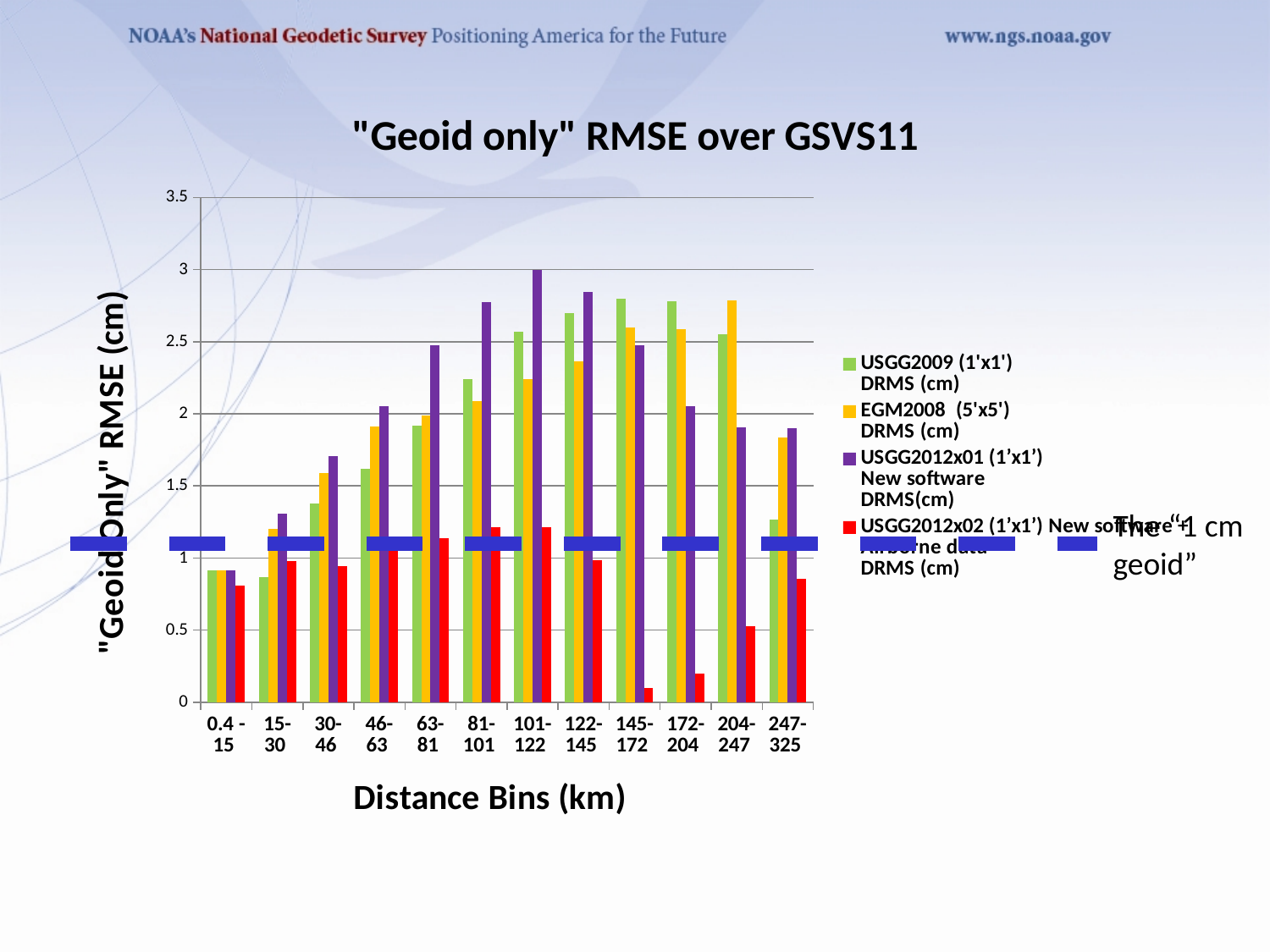
What is the title of the chart? "Geoid only" RMSE over GSVS11 How many distance bins are shown on the x axis of the chart? 12 Is the USGG2012x01 (1'x1') New software DRMS value for the 101-122 km bin greater or less than 2.5? greater In which distance bin does the USGG2012x01 (1'x1') New software DRMS series reach its highest value? 101-122 What is the x-axis title of the chart? Distance Bins (km) Is the USGG2012x02 (1'x1') New software + Airborne data DRMS value for the 172-204 km bin greater or less than 0.5? less Is the USGG2012x02 (1'x1') New software + Airborne data DRMS value for the 145-172 km bin greater or less than 0.5? less How many series does the chart's legend list? 4 In which distance bin does the USGG2012x02 (1'x1') New software + Airborne data DRMS series have its lowest value? 145-172 What kind of chart is shown on the slide? bar chart For the 101-122 km bin, which is larger: the USGG2012x01 (1'x1') New software DRMS value or the USGG2012x02 (1'x1') New software + Airborne data DRMS value? USGG2012x01 (1'x1') New software DRMS